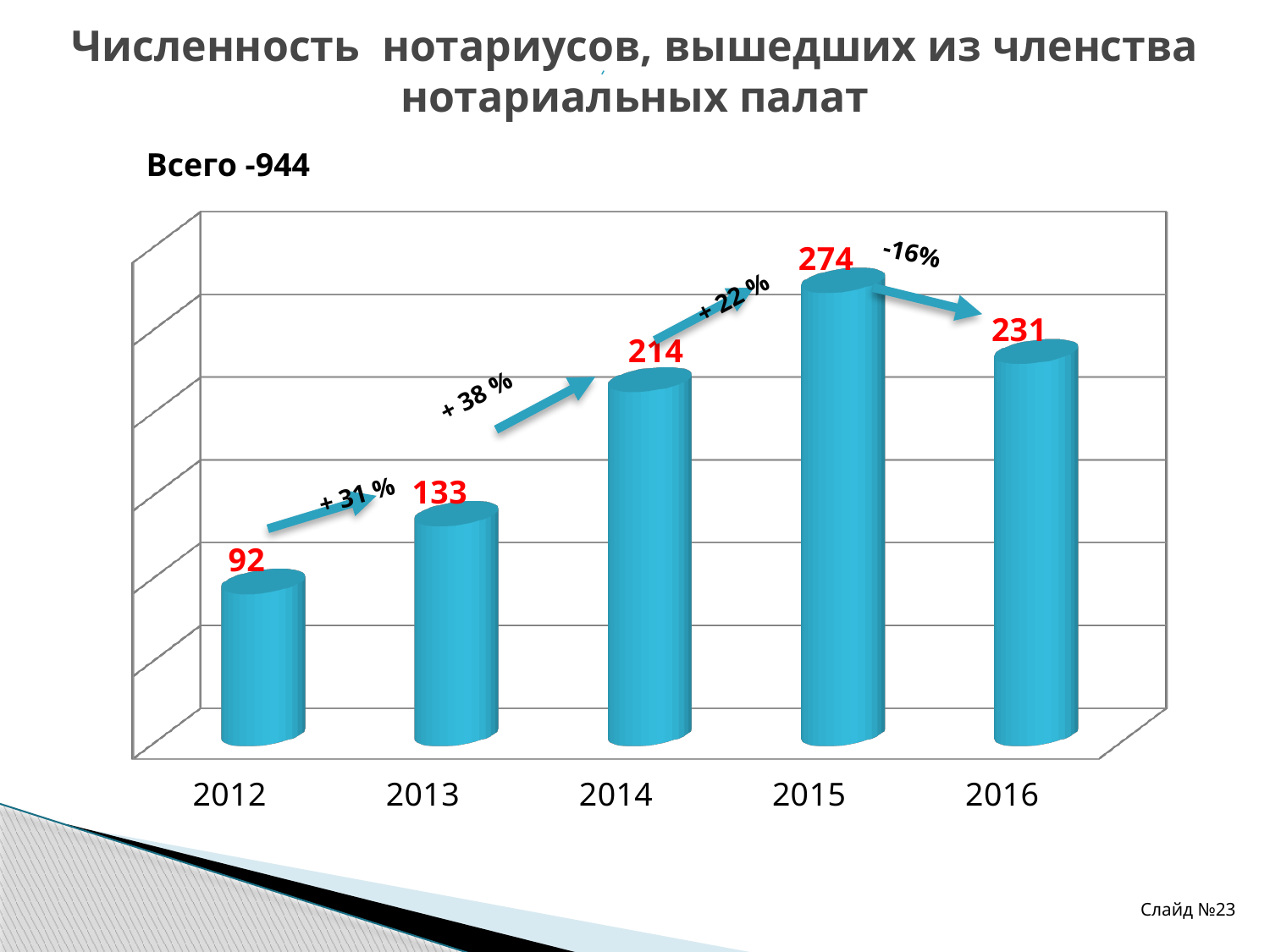
Which year has the highest value? 2015 What kind of chart is this? bar chart What is the value for 2012? 92 Do the values rise or fall from 2012 to 2015? rise What is the difference between the values for 2015 and 2016? 43 What percentage change is labelled between 2015 and 2016? -16% Which year has the lowest value? 2012 Which is larger, the value for 2014 or the value for 2016? 2016 How many years are shown on the x axis? 5 What is the value for 2014? 214 What is the difference between the values for 2013 and 2012? 41 What is the value for 2016? 231